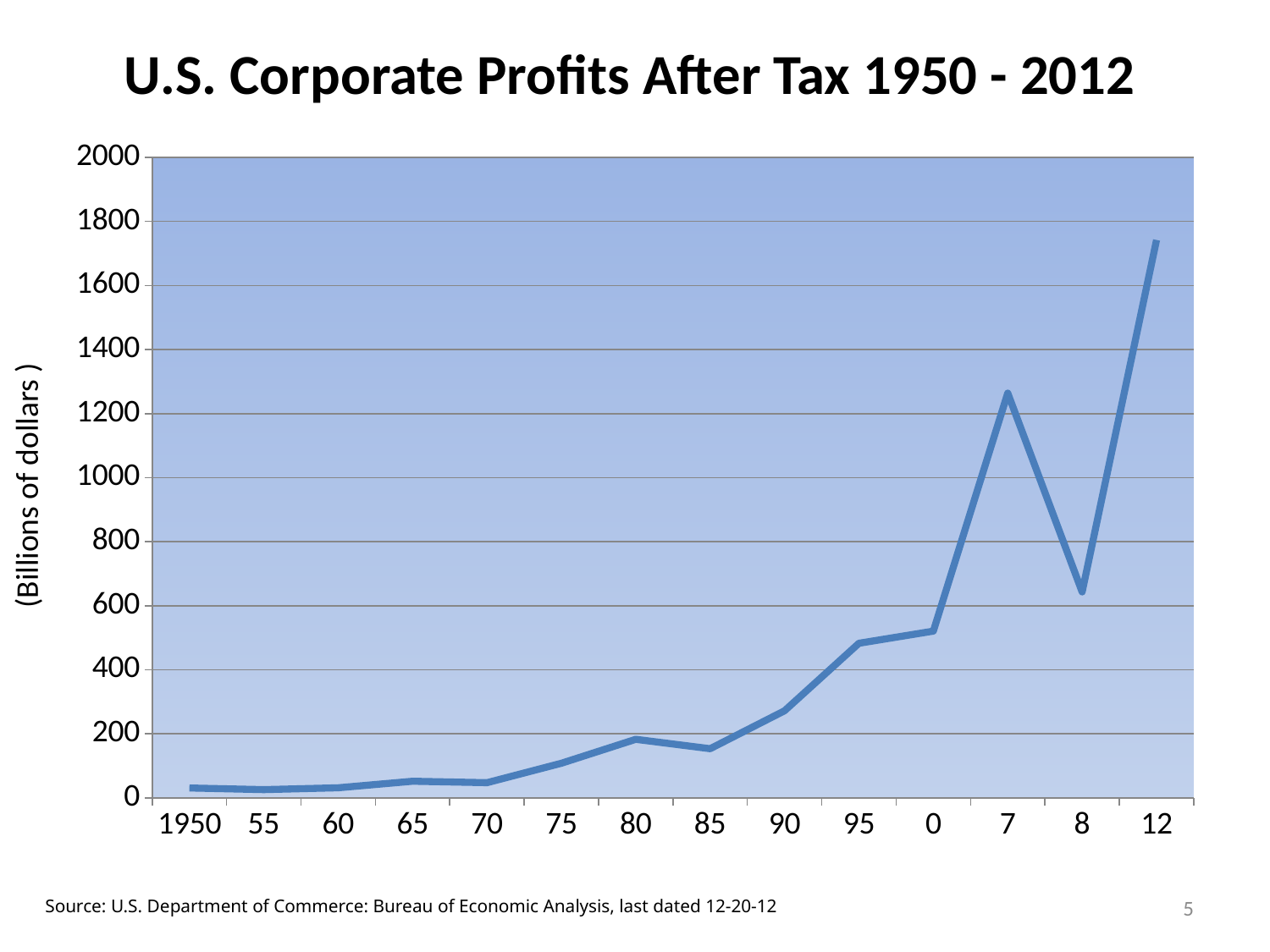
What kind of chart is shown on the slide? line chart Which is larger, the value for 95 or the value for 90? 95 Which is larger, the value for 7 or the value for 8? 7 What is the label on the y axis? (Billions of dollars ) Is the value for 8 greater or less than 800? less Is the value for 0 greater or less than 400? greater Is the value for 12 greater or less than 1600? greater Do the values rise or fall between 7 and 8? fall Which year has the highest corporate profits after tax? 12 How many points are plotted along the x axis? 14